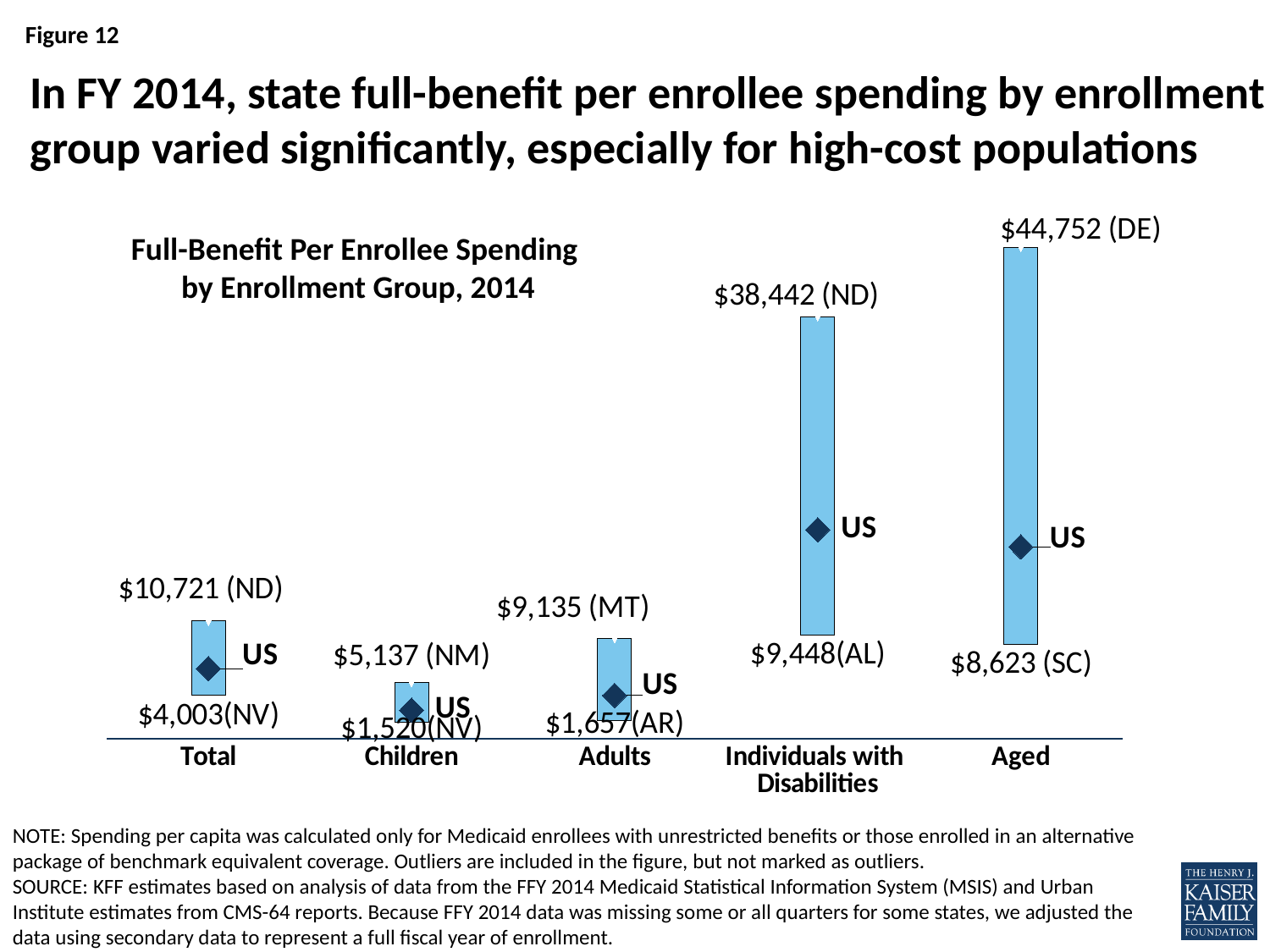
Is the highest state value for Adults larger or smaller than the highest state value for Children? larger Which enrollment group has the lowest bottom-of-range state value? Children What is the title of the chart? Full-Benefit Per Enrollee Spending by Enrollment Group, 2014 What is the difference between the highest and lowest state values shown for the Total group? $6,718 What is the highest state full-benefit per enrollee spending value shown for the Aged group, and which state is it? $44,752 (DE) What is the lowest state value shown for the Adults group? $1,657 (AR) Which state has the highest per enrollee spending in the Total group, and what is the value? ND, $10,721 What is the lowest state value shown for the Individuals with Disabilities group? $9,448 (AL) How many enrollment groups are shown on the x axis? 5 What is the difference between the highest state value for Individuals with Disabilities and the highest state value for Aged? $6,310 What is the highest state value shown for the Children group? $5,137 (NM) Which enrollment group has the highest top-of-range state value? Aged